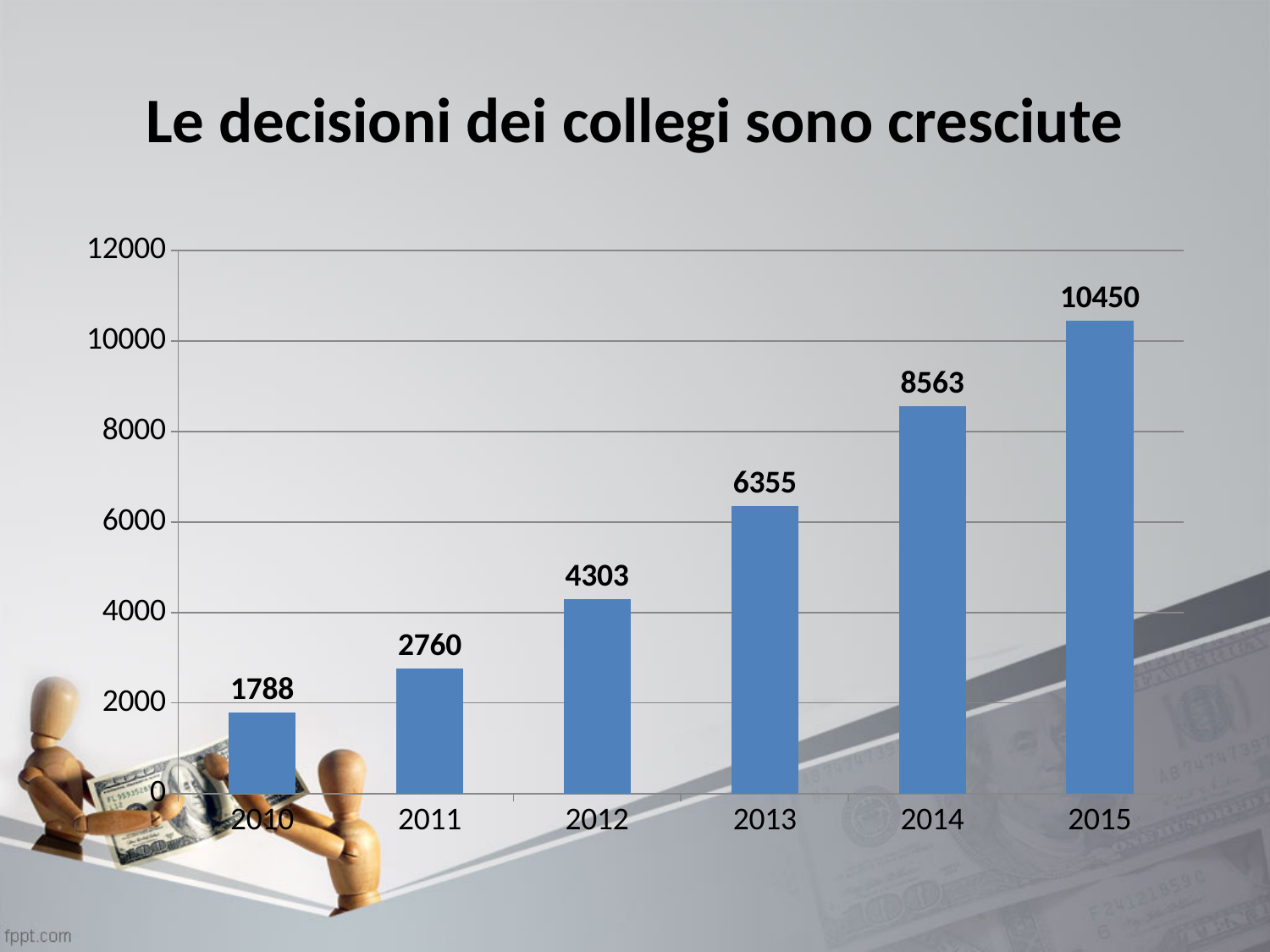
Which year has the highest value? 2015 How many years are shown on the x axis? 6 Is the value for 2013 greater or less than 6000? greater What is the difference between the values for 2011 and 2010? 972 What is the value for 2014? 8563 What kind of chart is shown on the slide? bar chart Which year has the lowest value? 2010 Do the values rise or fall from 2010 to 2015? rise Which is larger, the value for 2013 or the value for 2012? 2013 What is the difference between the values for 2015 and 2014? 1887 What is the value for 2012? 4303 What is the value for 2010? 1788